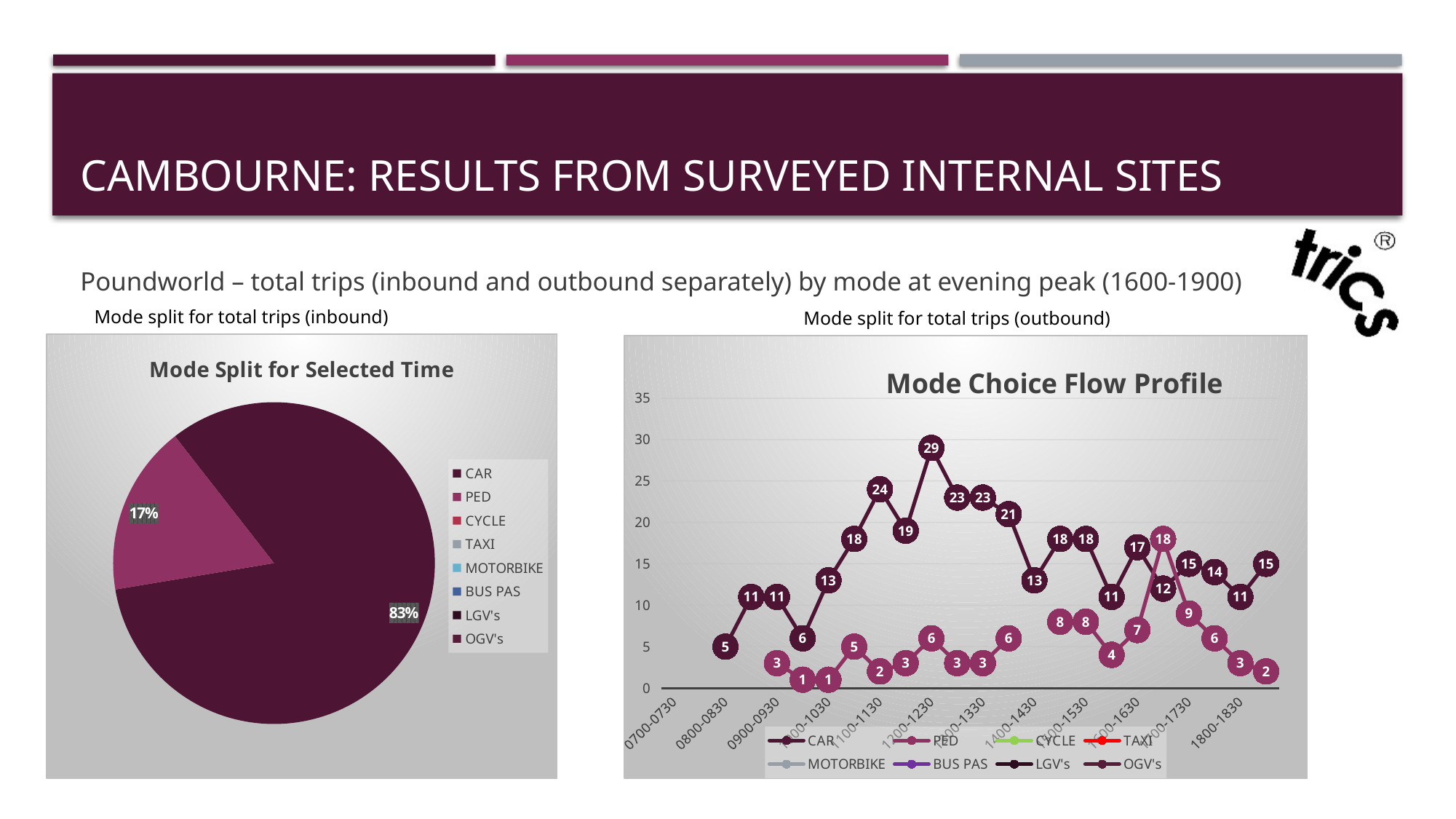
In the 'Mode Split for Selected Time' pie chart, what share of trips is CAR? 83% In the 'Mode Split for Selected Time' pie chart, which mode has the largest slice? CAR What type of chart is the 'Mode Choice Flow Profile' chart on the right? Line chart How many series does the legend of the 'Mode Choice Flow Profile' chart list? 8 In the 'Mode Choice Flow Profile' chart, what is the lowest value plotted for the PED series? 1 What type of chart is the 'Mode Split for Selected Time' chart on the left? Pie chart In the 'Mode Split for Selected Time' pie chart, by how many percentage points does the CAR share exceed the PED share? 66 In the 'Mode Split for Selected Time' pie chart, what share of trips is PED? 17% In the 'Mode Choice Flow Profile' chart, what is the highest value plotted for the CAR series? 29 In the 'Mode Choice Flow Profile' chart, what is the difference between the peak CAR value and the peak PED value? 11 In the 'Mode Choice Flow Profile' chart, what is the highest value plotted for the PED series? 18 How many entries does the legend of the 'Mode Split for Selected Time' pie chart list? 8